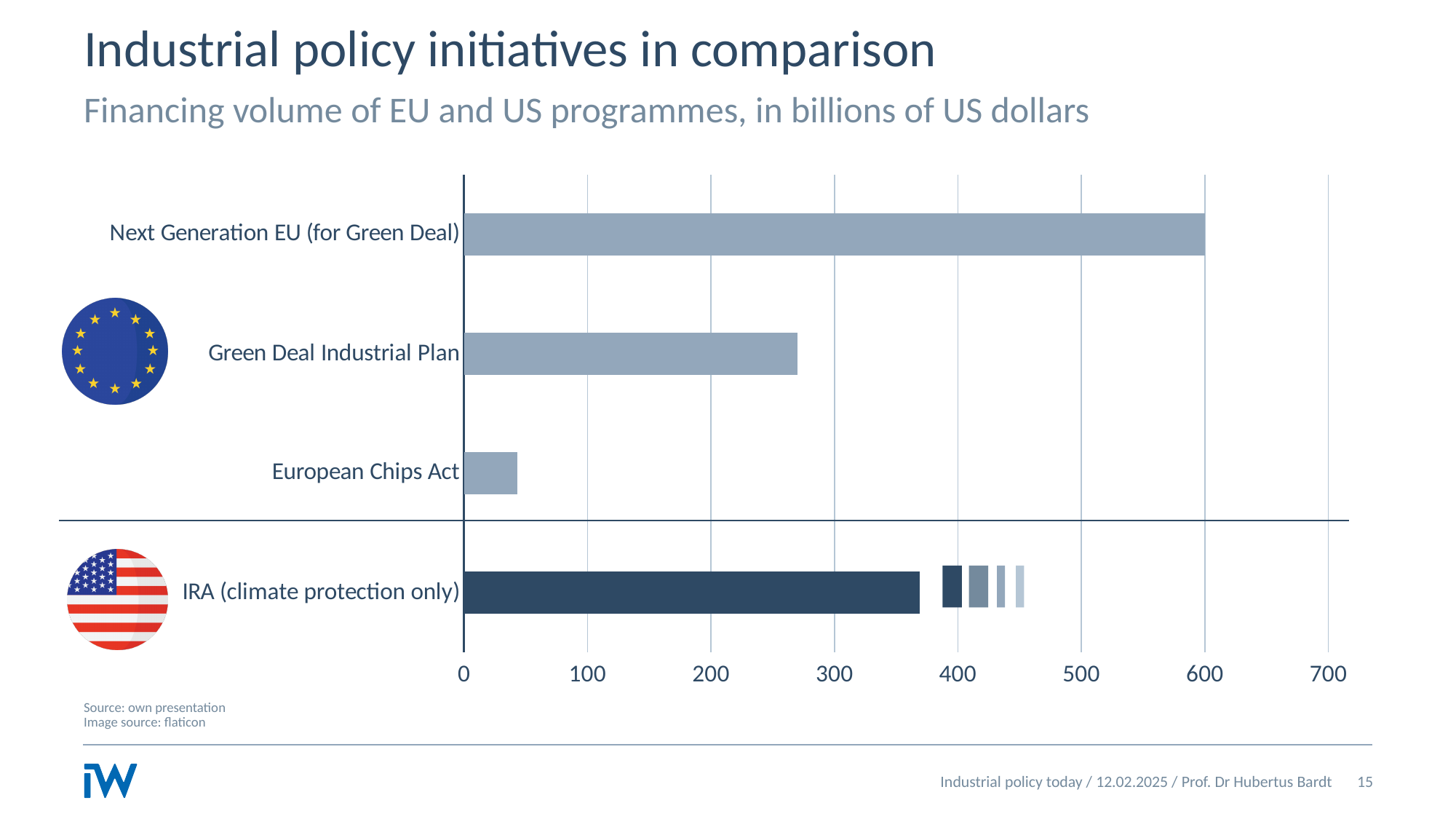
Which programme has the smallest financing volume in the chart? European Chips Act Is the value for Green Deal Industrial Plan greater or less than 300? less Which programme has the largest financing volume in the chart? Next Generation EU (for Green Deal) Which is larger: the value for Green Deal Industrial Plan or the value for European Chips Act? Green Deal Industrial Plan Which is larger: the value for IRA (climate protection only) or the value for Green Deal Industrial Plan? IRA (climate protection only) Is the value for European Chips Act greater or less than 100? less Is the value for IRA (climate protection only) greater or less than 300? greater What is the financing volume of Next Generation EU (for Green Deal), in billions of US dollars? 600 What kind of chart is shown on the slide? bar chart In what unit are the financing volumes in the chart expressed, according to the subtitle? billions of US dollars How many programmes (categories) are plotted in the chart? 4